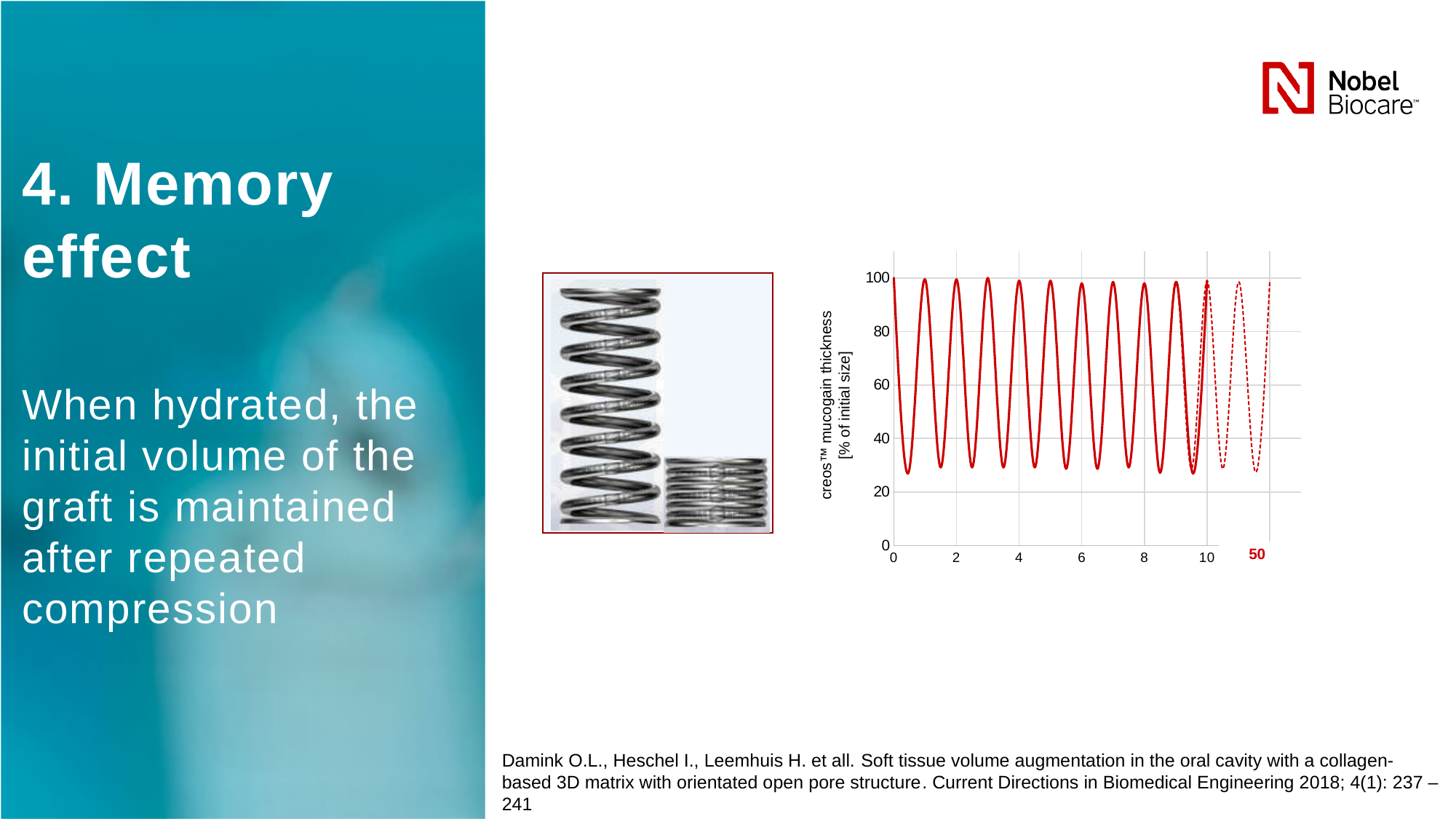
Is the value at x = 8.5 greater or less than 40? less What kind of chart is shown on the slide? line chart Is the value at x = 1 greater or less than 80? greater Is the value at x = 4 greater or less than 80? greater What is the highest tick value shown on the y axis? 100 Do the peak values of the line rise, fall, or stay roughly constant as x increases? stay roughly constant What colour is the plotted line in the chart? red What is the label of the y axis of the chart? creos™ mucogain thickness [% of initial size]